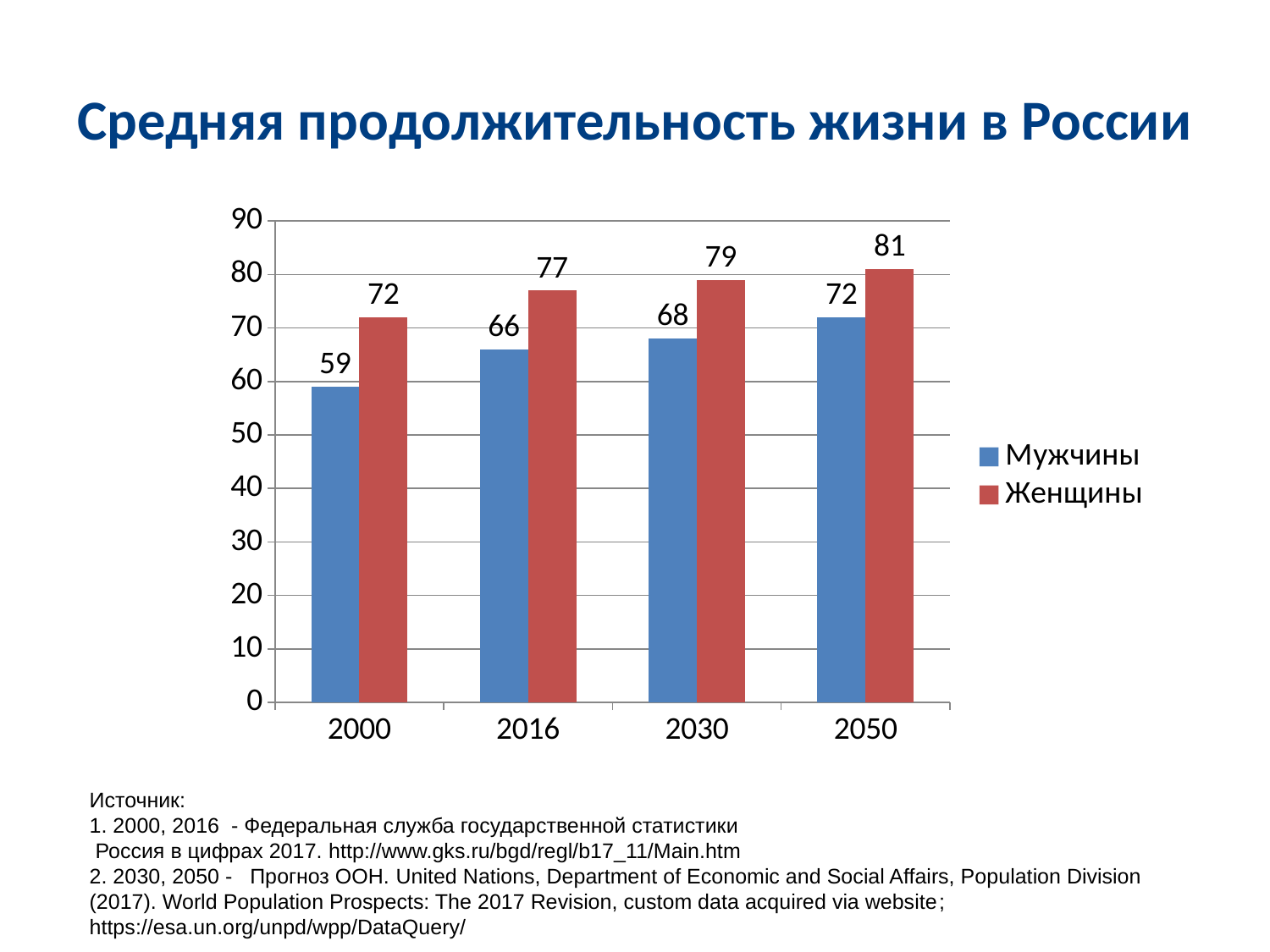
Is the value for Мужчины in 2016 greater or less than 70? less What is the value for Женщины in 2016? 77 How many series does the legend list? 2 Which is larger: Мужчины in 2050 or Женщины in 2000? They are equal (72) What is the value for Мужчины in 2000? 59 What is the value for Женщины in 2050? 81 Which year has the lowest value for Женщины? 2000 Do the values for Женщины rise or fall from 2000 to 2050? rise How many years are shown on the x axis? 4 Which year has the highest value for Мужчины? 2050 What kind of chart is shown on the slide? bar chart What is the difference between Женщины and Мужчины in 2030? 11